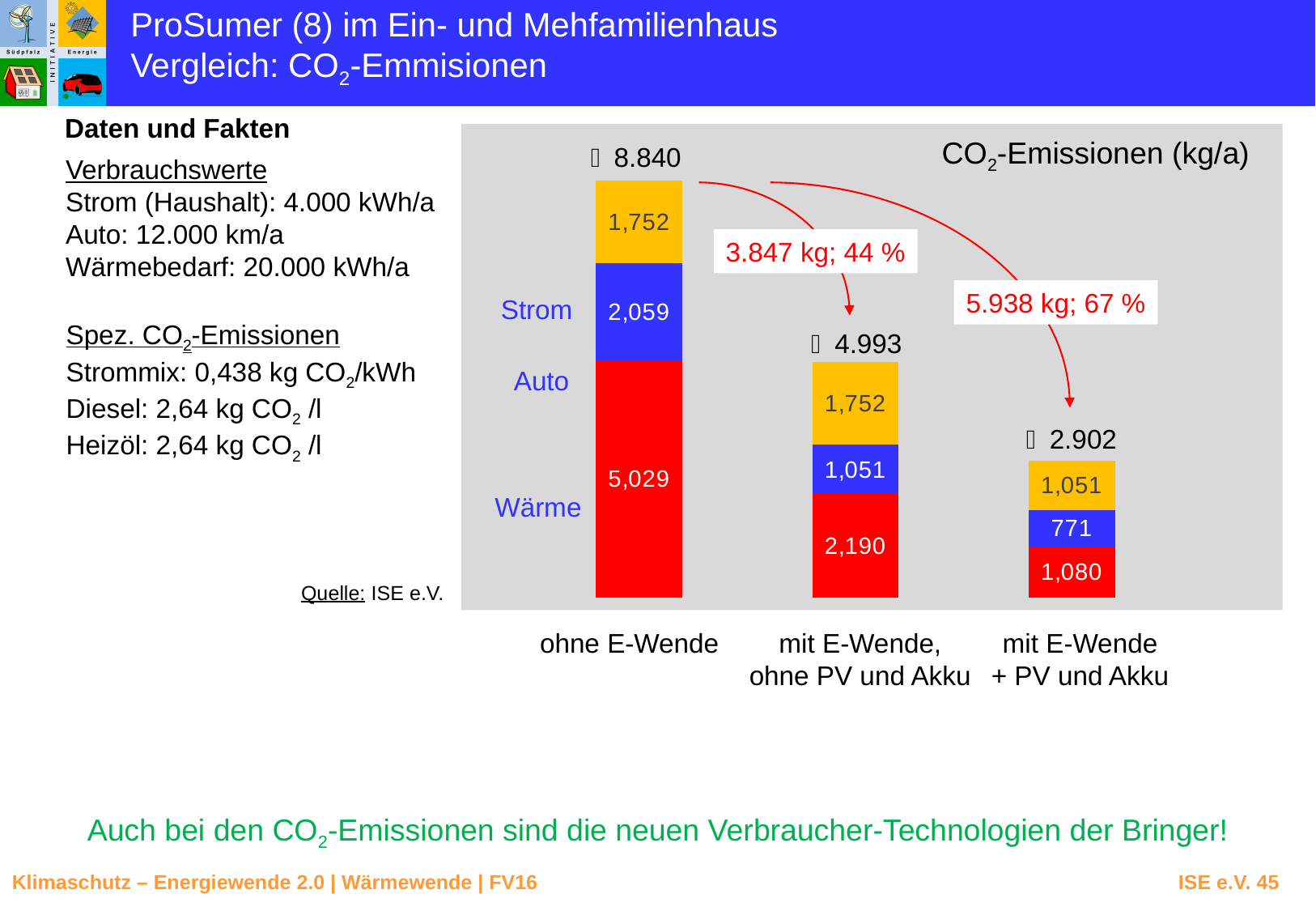
What is the total CO2 emission shown above the 'mit E-Wende, ohne PV und Akku' bar? 4.993 What kind of chart is shown on the slide? Stacked bar chart What is the value of the red (bottom) segment of the 'ohne E-Wende' bar? 5,029 What is the total CO2 emission shown above the 'ohne E-Wende' bar? 8.840 Do the total CO2 emissions rise or fall from left to right across the three bars? Fall How many scenarios (bars) are shown in the chart? 3 Which scenario has the lowest total CO2 emissions? mit E-Wende + PV und Akku What is the value of the blue (middle) segment of the 'mit E-Wende + PV und Akku' bar? 771 What is the value of the red (bottom) segment of the 'mit E-Wende, ohne PV und Akku' bar? 2,190 Is the blue (middle) segment larger for 'ohne E-Wende' or for 'mit E-Wende, ohne PV und Akku'? ohne E-Wende Which scenario has the highest total CO2 emissions? ohne E-Wende By how much do the CO2 emissions fall from 'ohne E-Wende' to 'mit E-Wende + PV und Akku', according to the annotation? 5.938 kg; 67 %